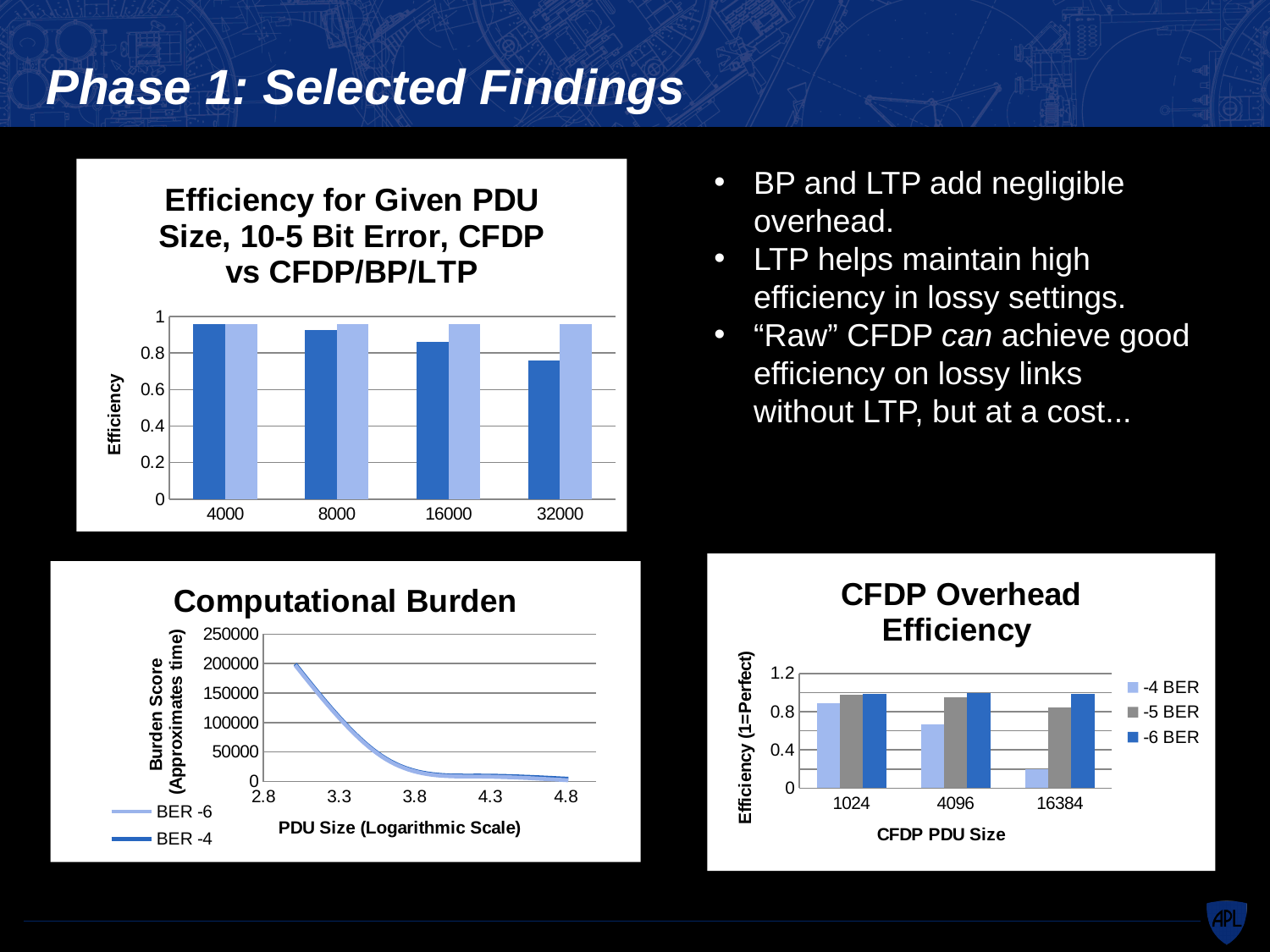
How many series does the legend of the 'Computational Burden' chart list? 2 What type of chart is the 'Computational Burden' chart? line chart In the 'Computational Burden' chart, is the burden score at PDU size 4.3 greater or less than 50000? less In the 'Efficiency for Given PDU Size' chart, do the dark blue bars rise or fall as PDU size increases from 4000 to 32000? fall In the 'Computational Burden' chart, does the burden score rise or fall as PDU size increases along the x axis? fall In the 'Efficiency for Given PDU Size' chart, which PDU size has the lowest dark blue bar? 32000 How many PDU size categories are shown on the x axis of the 'Efficiency for Given PDU Size' chart? 4 What type of chart is the 'Efficiency for Given PDU Size, 10-5 Bit Error, CFDP vs CFDP/BP/LTP' chart? bar chart In the 'Efficiency for Given PDU Size' chart, is the dark blue bar for 16000 greater or less than 0.8? greater In the 'CFDP Overhead Efficiency' chart, which CFDP PDU size has the lowest -4 BER bar? 16384 In the 'CFDP Overhead Efficiency' chart, is the -4 BER value for 16384 greater or less than 0.4? less How many series does the legend of the 'CFDP Overhead Efficiency' chart list? 3